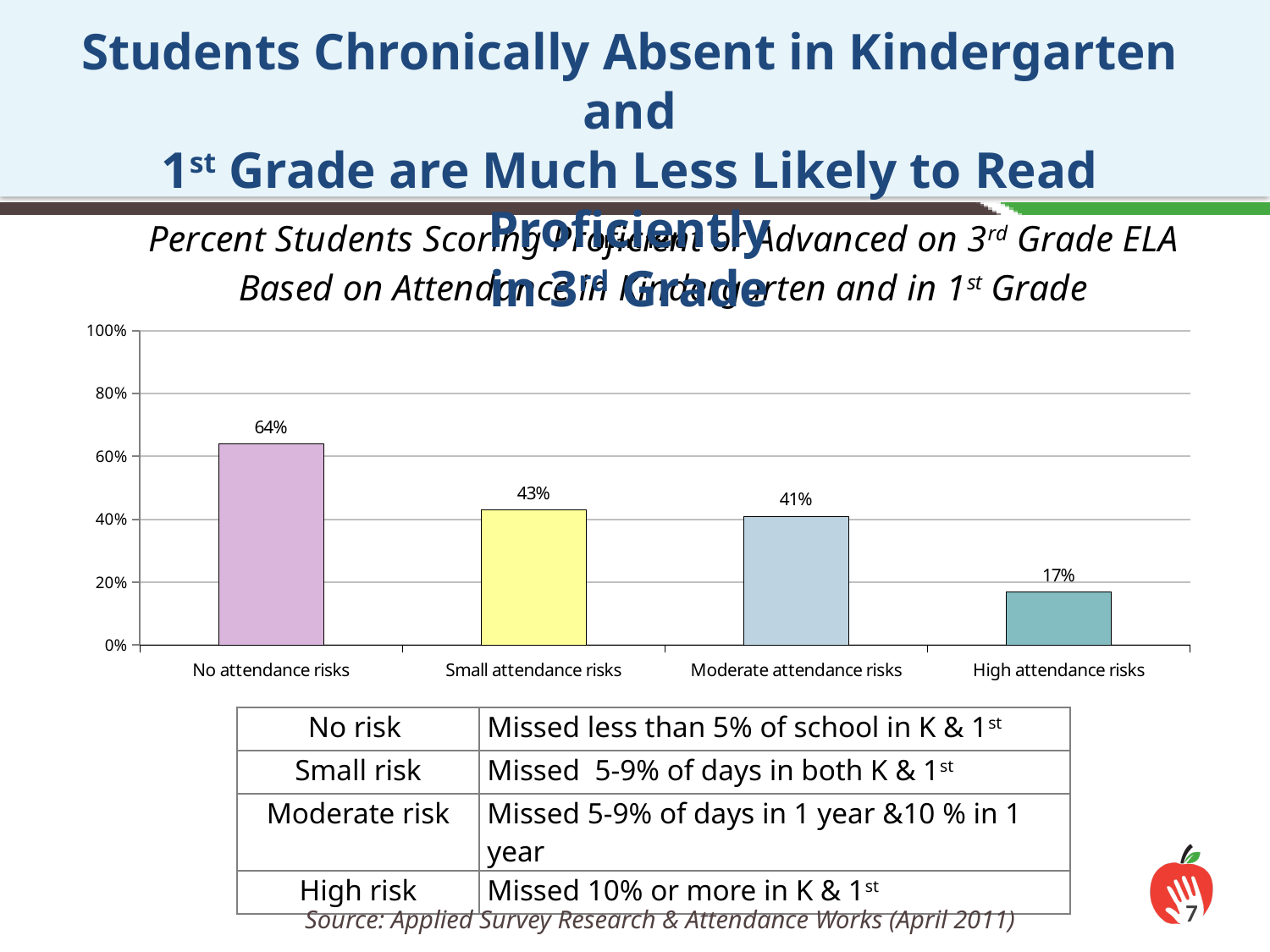
What percent of students with no attendance risks scored proficient or advanced on 3rd grade ELA? 64% Do the values rise or fall moving from 'No attendance risks' to 'High attendance risks' along the x axis? Fall What is the value shown for the 'Moderate attendance risks' category? 41% Which attendance risk category has the lowest percent of students scoring proficient or advanced? High attendance risks What is the difference in percentage points between the 'Small attendance risks' and 'Moderate attendance risks' bars? 2 How many attendance risk categories are plotted on the chart? 4 What is the value shown for the 'High attendance risks' category? 17% What is the difference in percentage points between the 'No attendance risks' and 'High attendance risks' bars? 47 What is the value shown for the 'Small attendance risks' category? 43% What kind of chart is shown on the slide? Bar chart Which attendance risk category has the highest percent of students scoring proficient or advanced? No attendance risks Which is larger, the value for 'No attendance risks' or the value for 'Small attendance risks'? No attendance risks